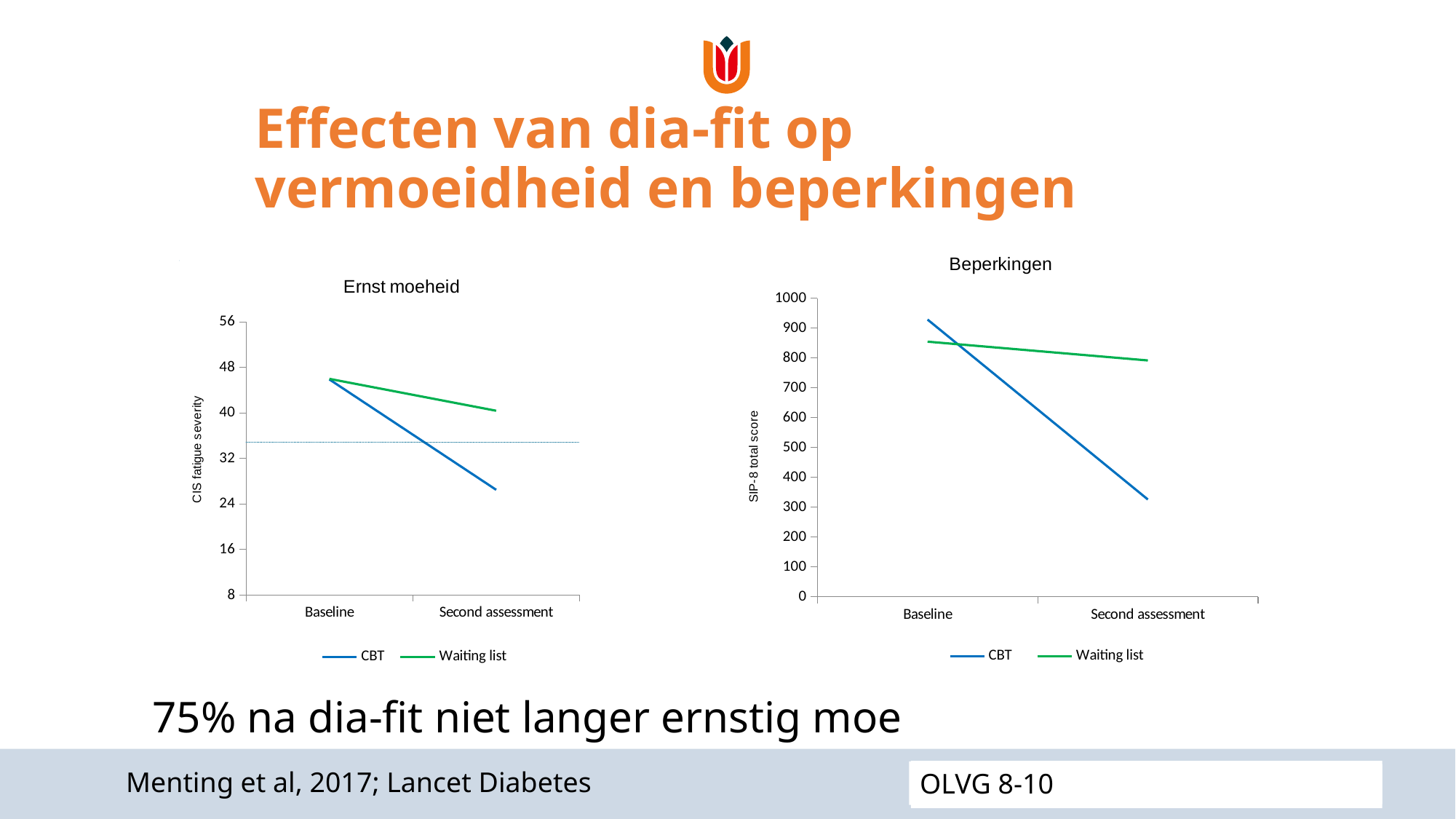
How many points are on the x axis of the 'Ernst moeheid' chart? 2 What kind of chart is the 'Ernst moeheid' chart? line chart What is the y-axis label of the 'Beperkingen' chart? SIP-8 total score In the 'Beperkingen' chart, does the Waiting list line rise or fall from Baseline to Second assessment? fall In the 'Beperkingen' chart, is the CBT value at Second assessment greater or less than 500? less In the 'Ernst moeheid' chart, is the CBT value at Second assessment greater or less than 32? less In the 'Beperkingen' chart, is the Waiting list value at Baseline greater or less than 800? greater In the 'Beperkingen' chart, which series has the larger value at Second assessment, CBT or Waiting list? Waiting list In the 'Ernst moeheid' chart, does the CBT line rise or fall from Baseline to Second assessment? fall What colour is the CBT line in the 'Ernst moeheid' chart? blue How many series does the legend of the 'Beperkingen' chart list? 2